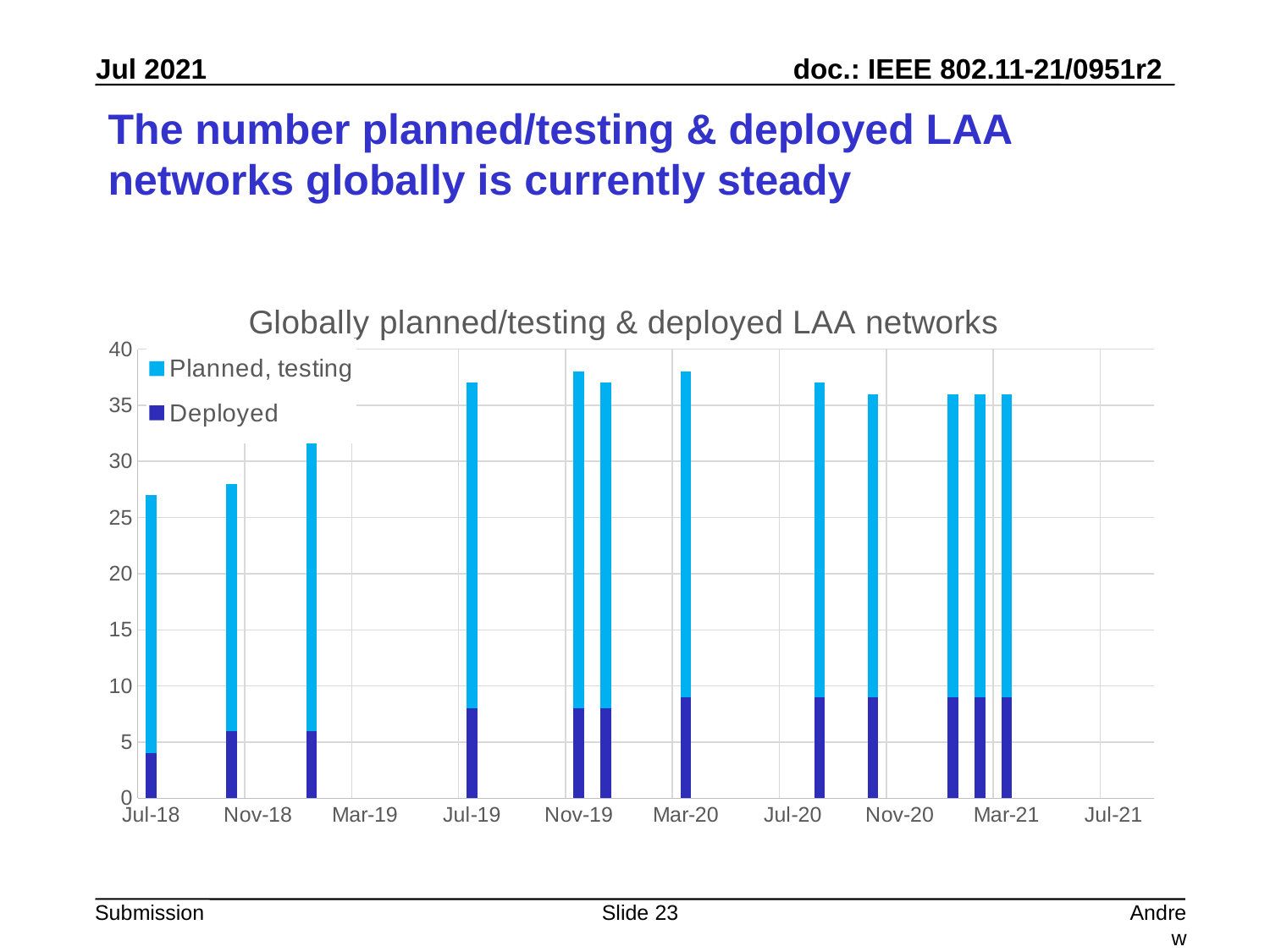
What is the title of the chart? Globally planned/testing & deployed LAA networks How many series does the legend list? 2 Is the total height of the bar at Nov-19 greater or less than 35? greater Is the total height of the bar at Jul-19 greater or less than 35? greater Does the Deployed series rise or fall from Jul-18 to Mar-21? Rise Which date has the lowest total bar? Jul-18 Which bar has the larger total, Jul-18 or Jul-19? Jul-19 What are the two series named in the legend? Planned, testing; Deployed Is the Deployed value at Mar-20 greater or less than 10? less What kind of chart is shown on the slide? Stacked bar chart